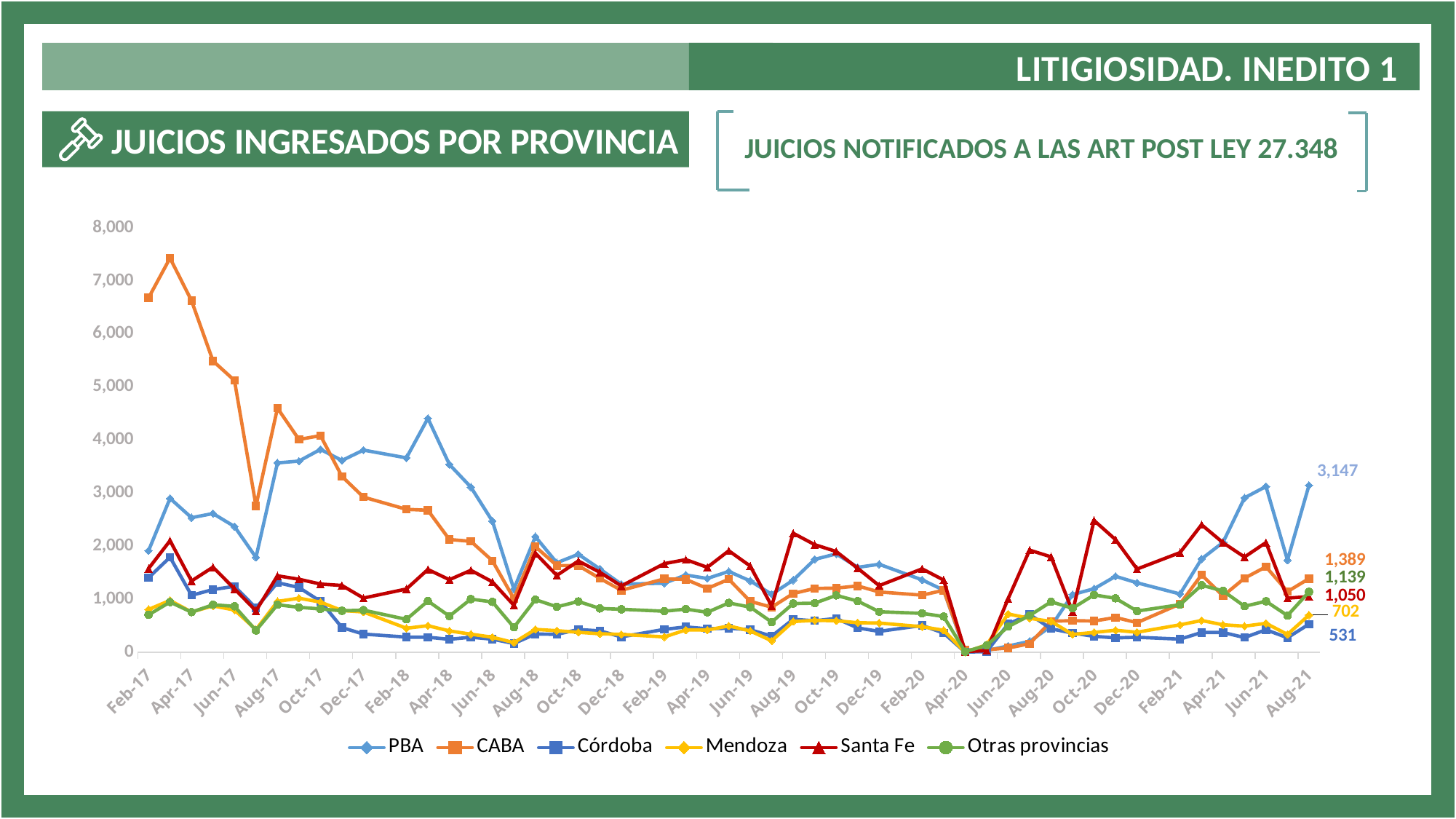
Is the value for CABA at Apr-17 greater or less than 7,000? less What is the value for PBA at Aug-21? 3,147 How many series does the legend list? 6 What is the value for CABA at Aug-21? 1,389 What kind of chart is shown on the slide? line chart Which series has the highest value at Aug-21? PBA What is the value for Santa Fe at Aug-21? 1,050 Which series has the lowest value at Aug-21? Córdoba What is the difference between the PBA and CABA values at Aug-21? 1,758 What is the value for Córdoba at Aug-21? 531 At Aug-21, which is larger: Santa Fe or Otras provincias? Otras provincias Does the CABA series rise or fall overall from Feb-17 to Aug-21? fall